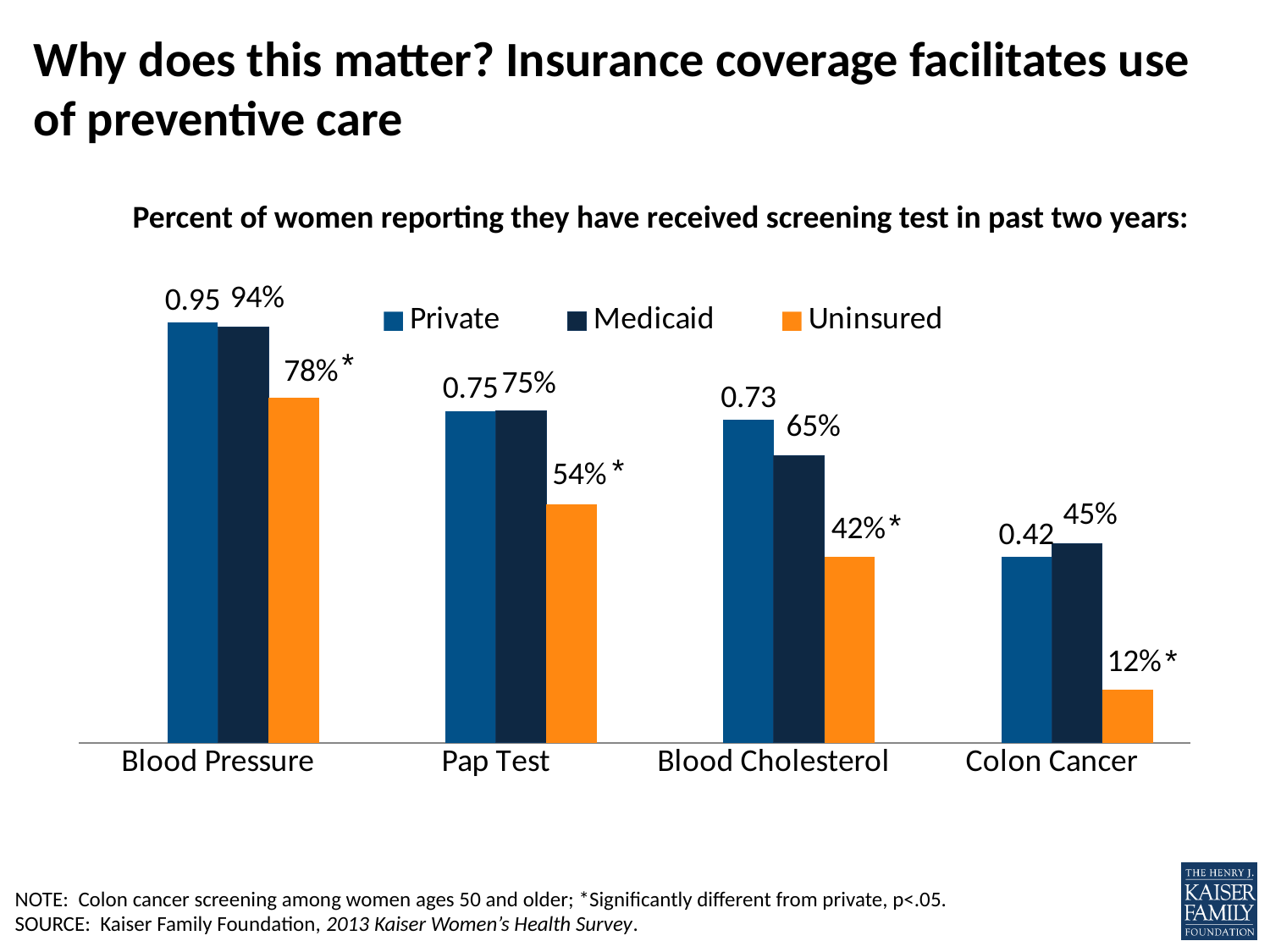
What kind of chart is shown on the slide? Bar chart For which screening test is the Uninsured value lowest? Colon Cancer How many screening test categories are shown on the x axis? 4 For Blood Cholesterol, which is larger: the Medicaid value or the Uninsured value? Medicaid What is the Uninsured value for Pap Test? 54% What is the Medicaid value for Blood Cholesterol? 65% For which screening test is the Medicaid value highest? Blood Pressure What is the difference between the Medicaid and Uninsured values for Colon Cancer? 33 percentage points What is the Private value for Blood Pressure? 0.95 What is the Medicaid value for Colon Cancer? 45% Do the Uninsured values rise or fall from Blood Pressure to Colon Cancer? Fall How many series does the legend list? 3